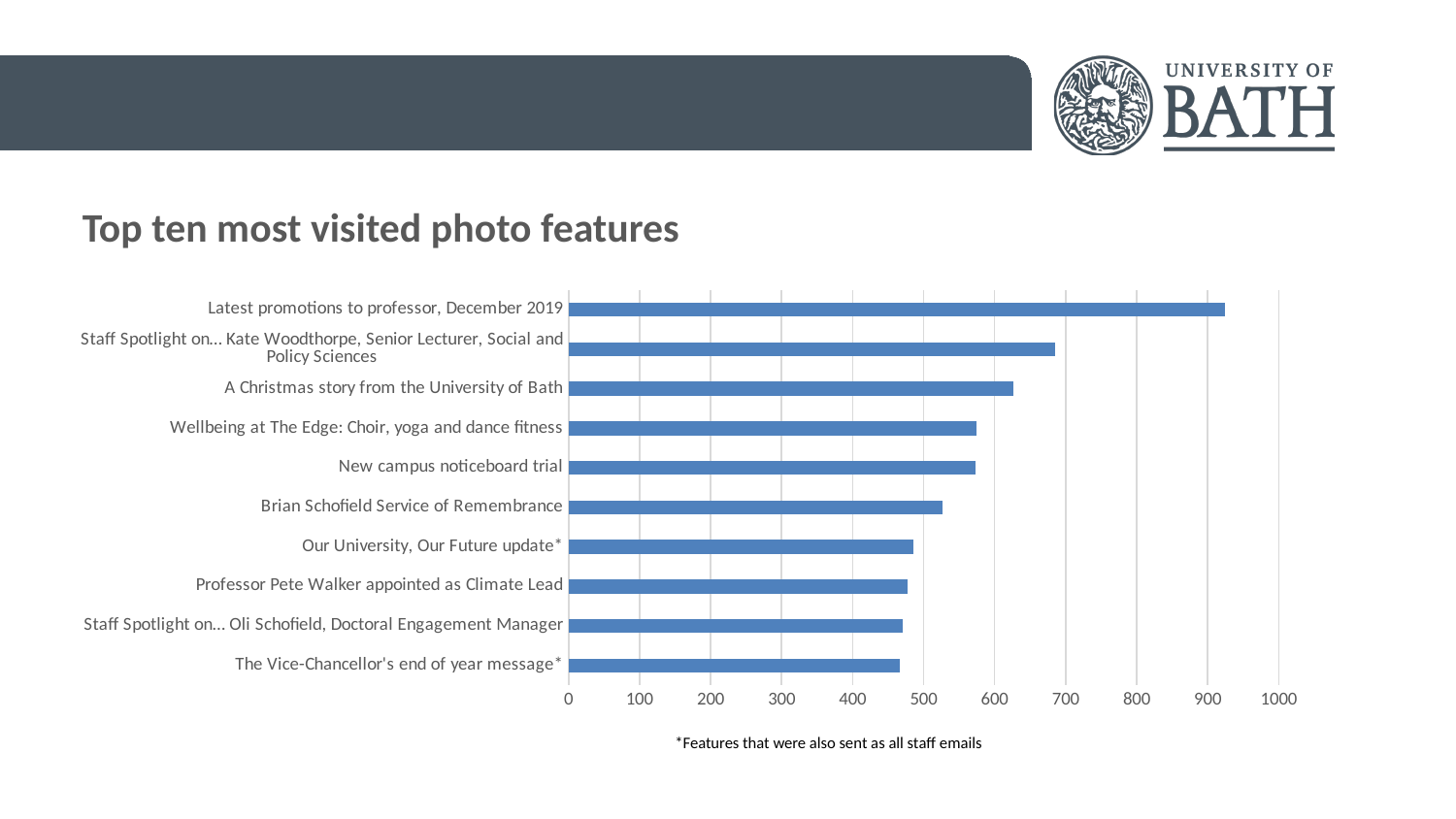
Is the value for "A Christmas story from the University of Bath" greater or less than 600? greater What kind of chart is shown on the slide? Bar chart Which photo feature has the highest number of visits? Latest promotions to professor, December 2019 Is the value for "Brian Schofield Service of Remembrance" greater or less than 500? greater Is the value for "Wellbeing at The Edge: Choir, yoga and dance fitness" greater or less than 500? greater What is the highest tick value shown on the horizontal axis? 1000 What is the title of the chart? Top ten most visited photo features Which has more visits: "A Christmas story from the University of Bath" or "Brian Schofield Service of Remembrance"? A Christmas story from the University of Bath How many photo features are plotted in the chart? 10